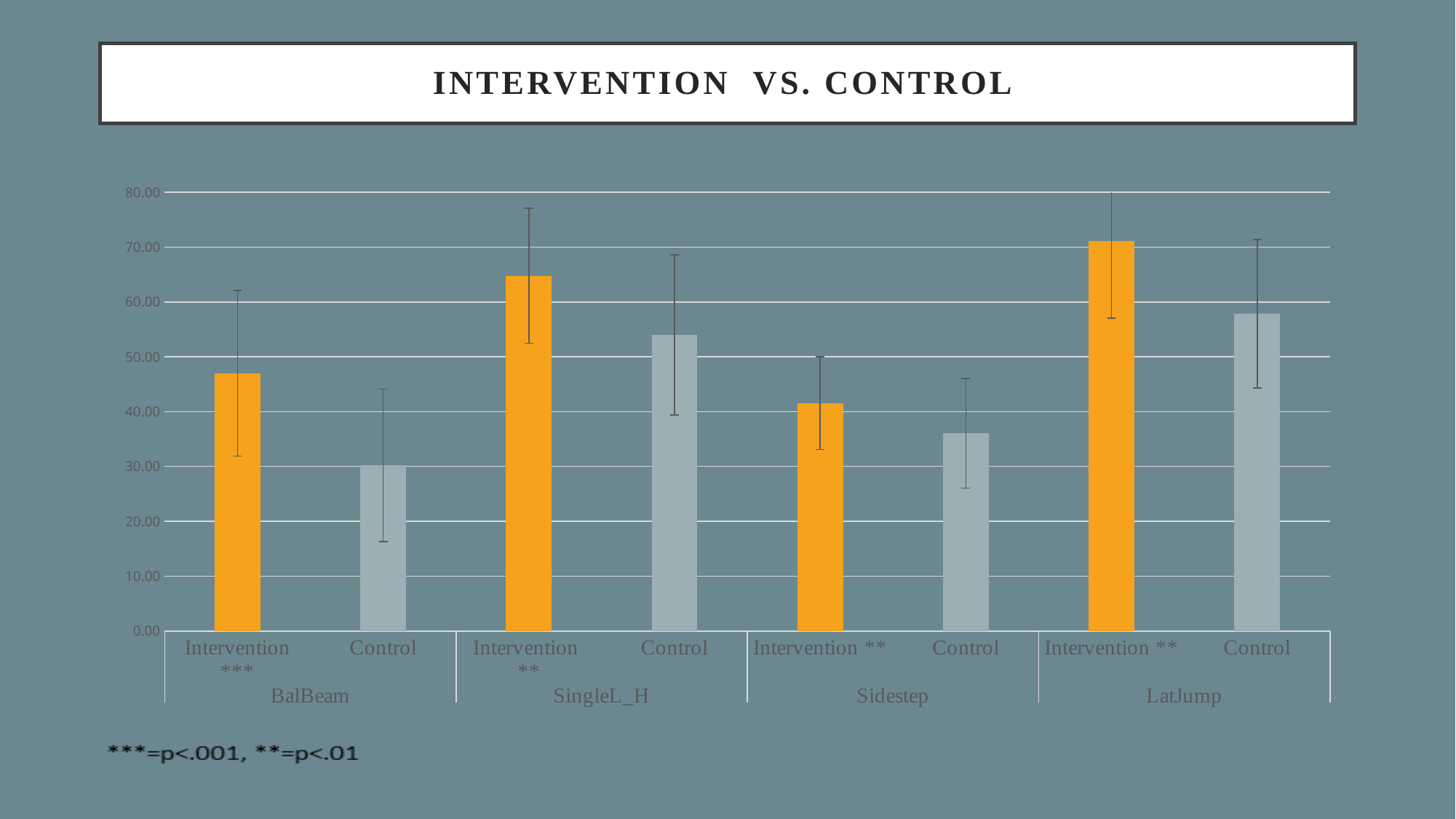
Is the value for the BalBeam Intervention bar greater or less than 40.00? greater Is the value for the BalBeam Control bar greater or less than 40.00? less Which bar is the highest on the chart? LatJump Intervention In the SingleL_H group, which bar is larger, Intervention or Control? Intervention Is the value for the Sidestep Control bar greater or less than 40.00? less Which bar is the lowest on the chart? BalBeam Control How many test categories (groups) are shown along the x axis? 4 How many bars are plotted in total on the chart? 8 What is the title of the chart? INTERVENTION VS. CONTROL What kind of chart is shown on the slide? bar chart